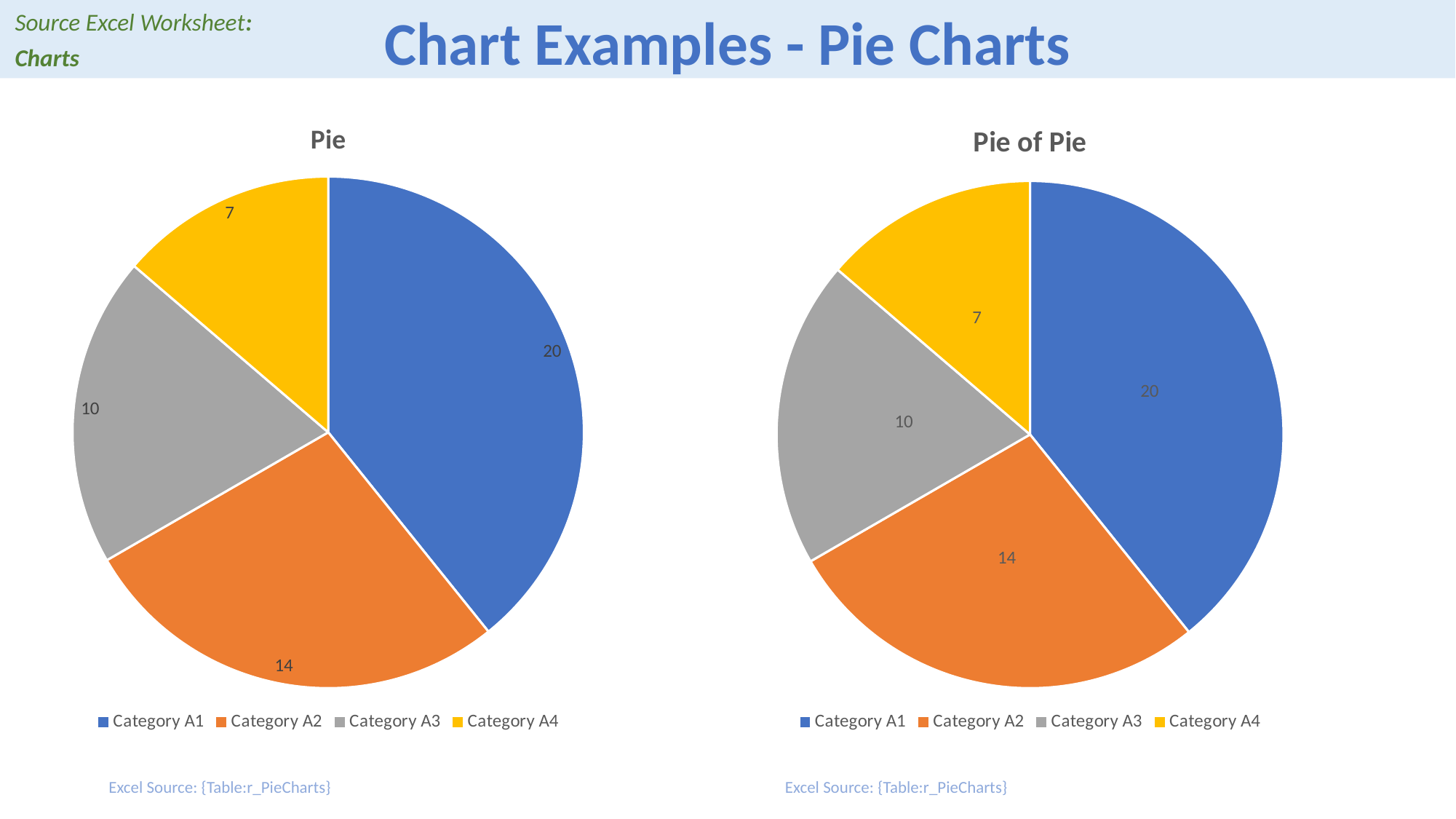
In the 'Pie of Pie' chart, what is the value for Category A2? 14 In the 'Pie' chart, which category has the largest slice? Category A1 In the 'Pie' chart, what is the value for Category A1? 20 In the 'Pie' chart, what is the value for Category A3? 10 In the 'Pie of Pie' chart, which category has the smallest slice? Category A4 In the 'Pie of Pie' chart, what is the difference between the values for Category A3 and Category A4? 3 In the 'Pie' chart, which is larger, Category A2 or Category A3? Category A2 What type of chart is the chart on the left of the slide? Pie chart What is the title of the chart on the right of the slide? Pie of Pie How many categories are shown in the 'Pie of Pie' chart? 4 In the 'Pie of Pie' chart, what is the value for Category A4? 7 In the 'Pie' chart, what is the difference between the values for Category A1 and Category A2? 6